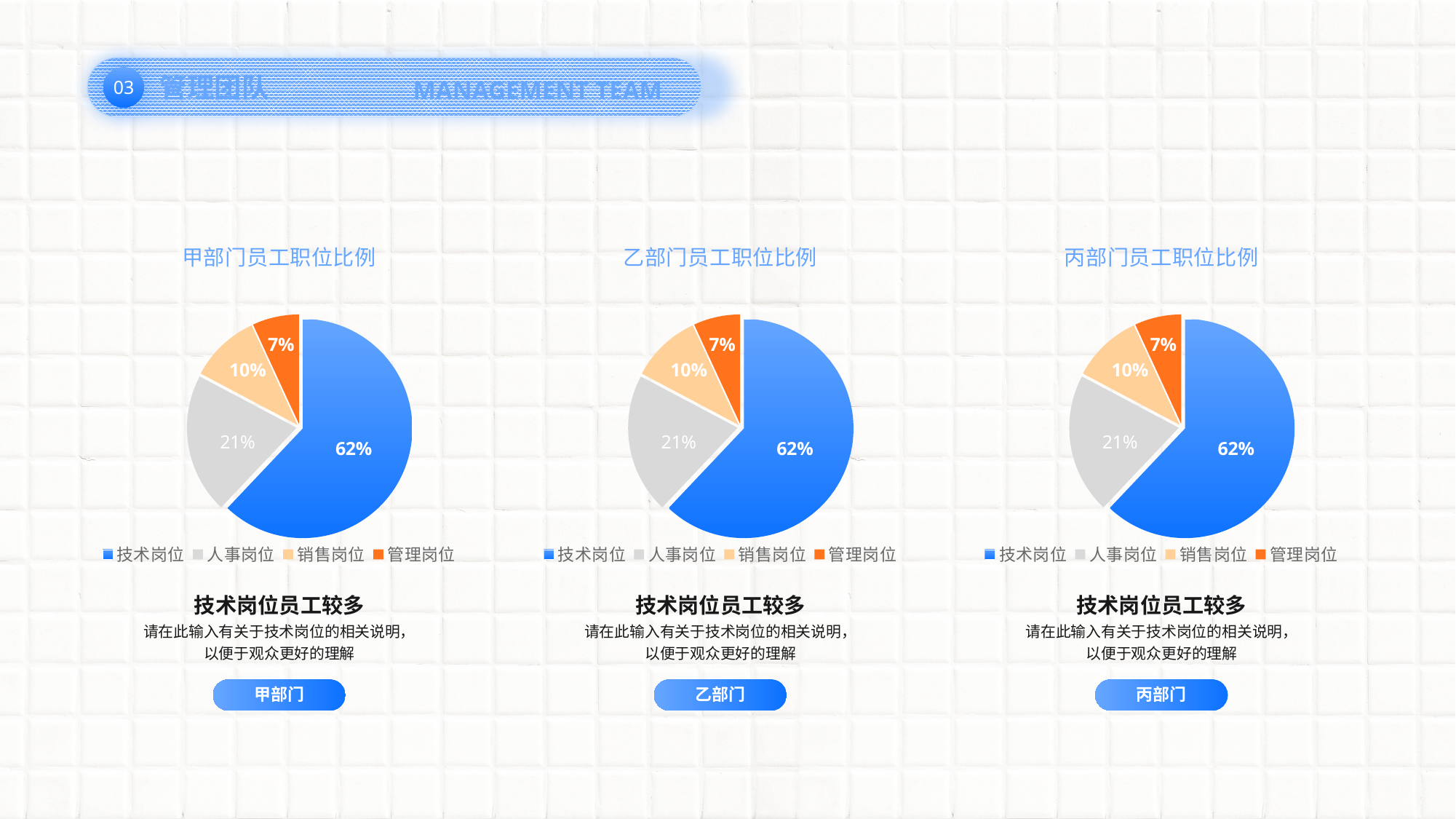
How many pie charts are on the slide? 3 In the chart titled 甲部门员工职位比例, what share of the pie is 管理岗位? 7% In the chart titled 丙部门员工职位比例, which category has the smallest slice? 管理岗位 In the chart titled 乙部门员工职位比例, what colour is the 管理岗位 slice? Orange How many categories does the chart titled 丙部门员工职位比例 show? 4 What kind of chart is the chart titled 甲部门员工职位比例? Pie chart In the chart titled 丙部门员工职位比例, what share of the pie is 销售岗位? 10% In the chart titled 甲部门员工职位比例, what share of the pie is 技术岗位? 62% In the chart titled 甲部门员工职位比例, what is the difference between the 技术岗位 and 人事岗位 shares? 41% In the chart titled 乙部门员工职位比例, which is larger, 销售岗位 or 管理岗位? 销售岗位 In the chart titled 乙部门员工职位比例, which category has the largest slice? 技术岗位